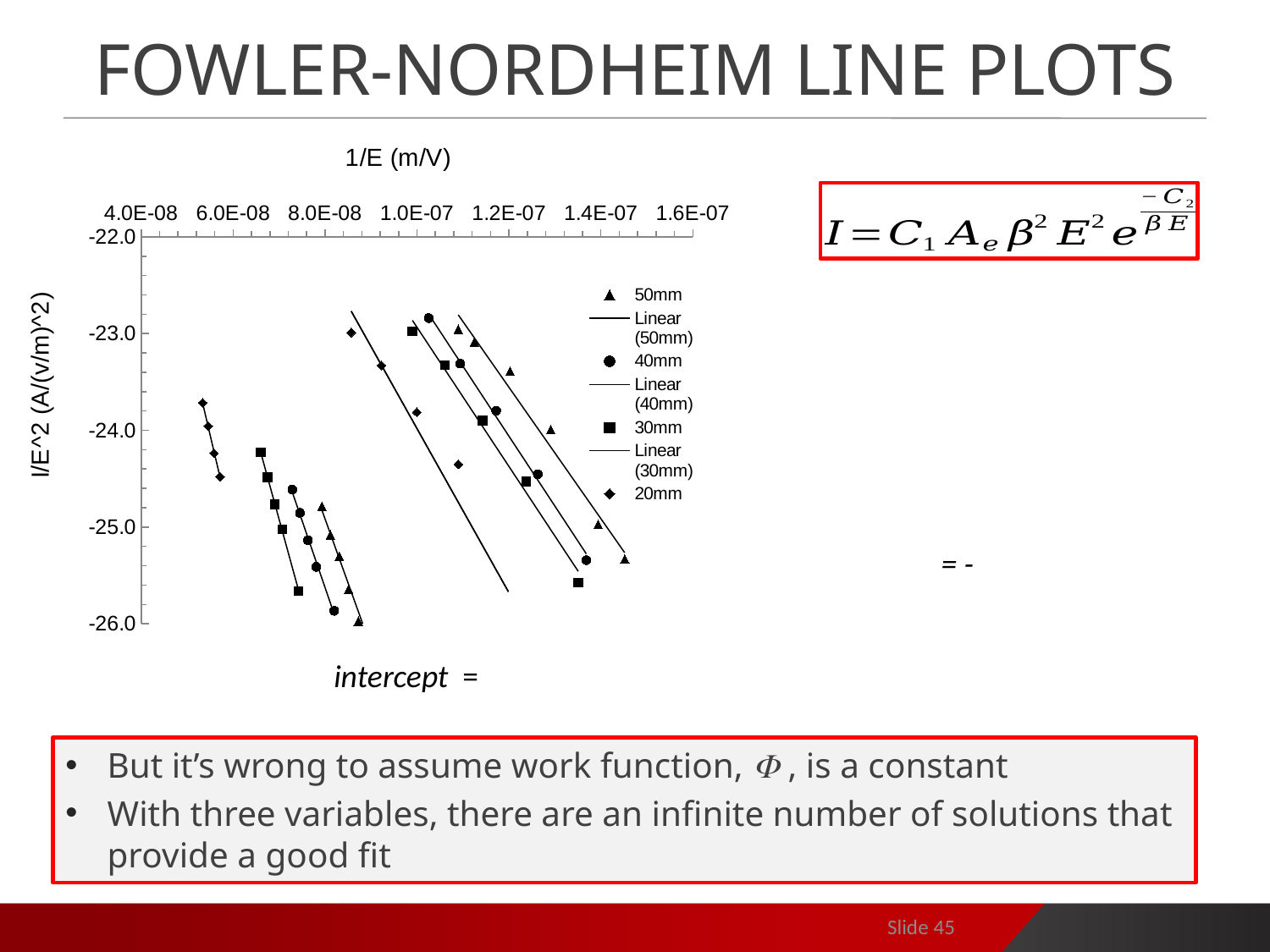
What kind of chart is shown on the slide? Scatter chart As 1/E increases along the x axis, do the plotted values rise or fall? Fall What is the title of the x axis of the chart? 1/E (m/V) How many different gap sizes (data series) are plotted in the chart? 4 How many entries does the chart legend list? 7 Is the lowest 30mm point greater or less than -25.0? less Is the lowest 50mm point greater or less than -25.0? less What is the title of the y axis of the chart? I/E^2 (A/(v/m)^2) Is the highest 20mm point greater or less than -24.0? greater What is the largest value shown on the x axis of the chart? 1.6E-07